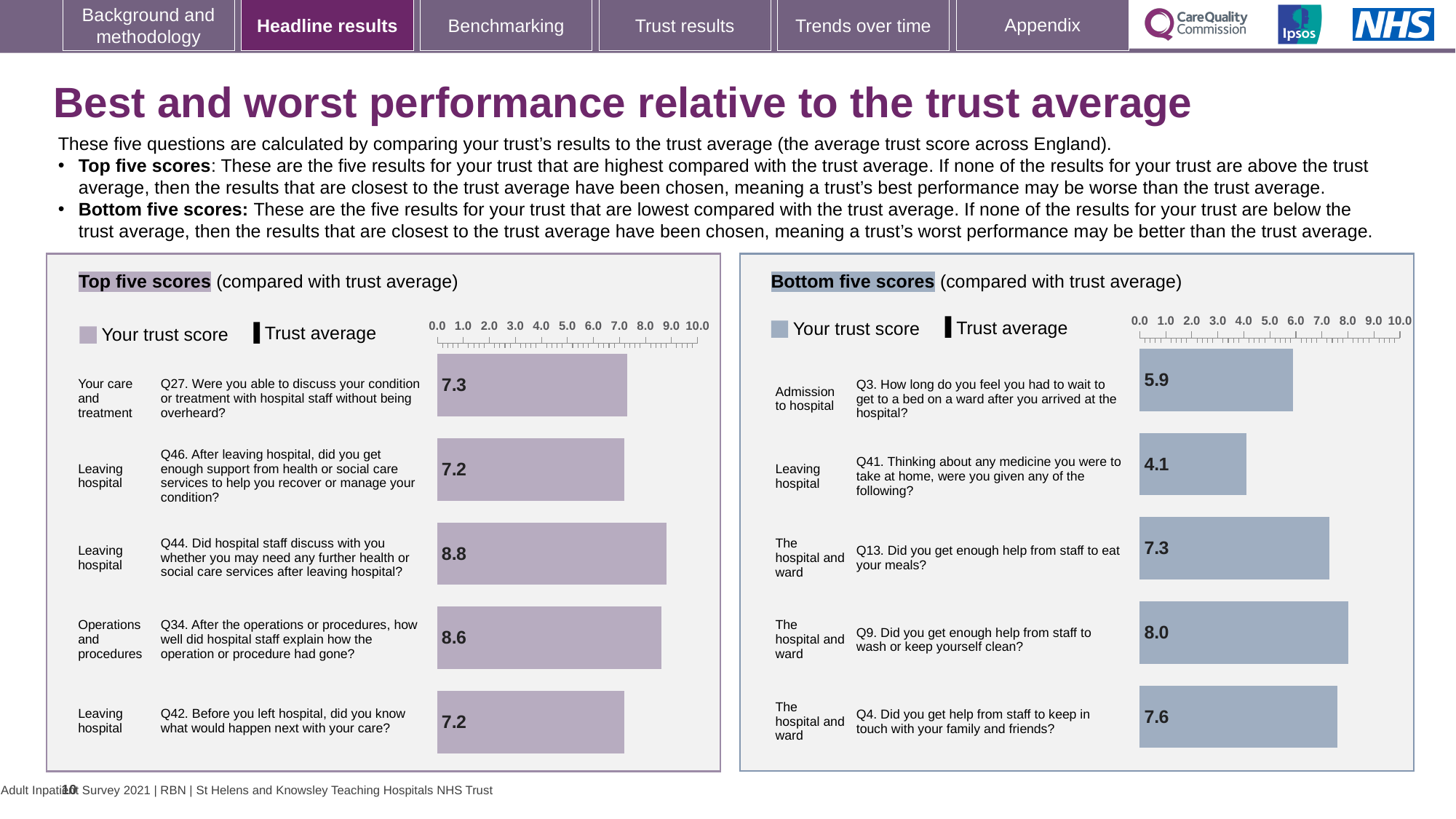
What type of chart is used in the Top five scores panel? Bar chart In the Bottom five scores chart, which question has the highest trust score? Q9 In the Bottom five scores chart, what is the difference between the scores for Q9 and Q3? 2.1 In the Bottom five scores chart, what is the trust score for Q41 (medicine to take at home)? 4.1 How many entries does the legend of the Bottom five scores chart list? 2 In the Top five scores chart, what is the trust score for Q27 (discussing your condition without being overheard)? 7.3 In the Bottom five scores chart, is the value for Q3 greater or less than 6.0? less In the Top five scores chart, how many questions are plotted? 5 In the Top five scores chart, what is the difference between the scores for Q44 and Q34? 0.2 In the Top five scores chart, which question has the highest trust score? Q44 In the Bottom five scores chart, is the score for Q13 or Q4 larger? Q4 In the Bottom five scores chart, which question has the lowest trust score? Q41